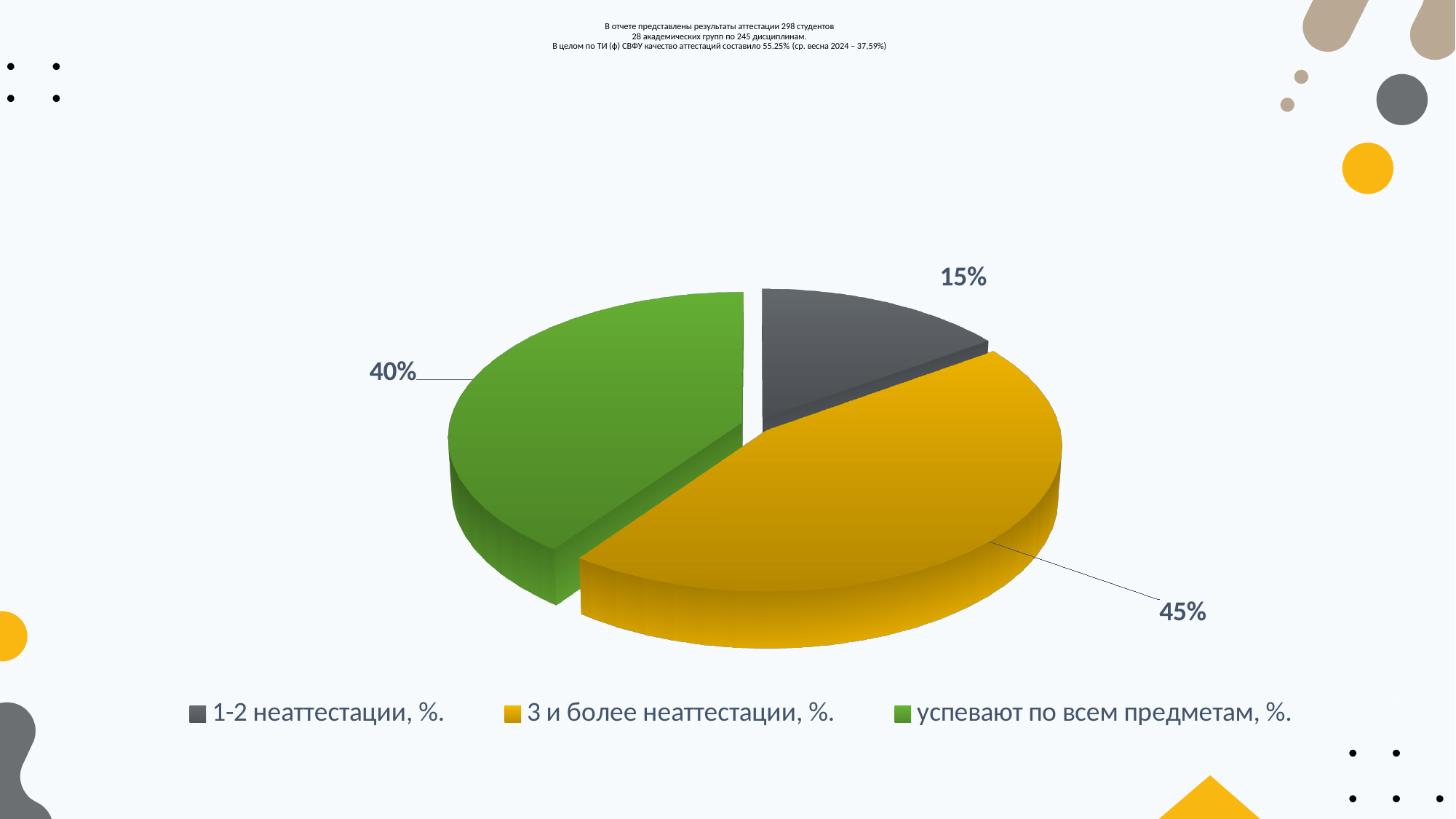
What is the value for "3 и более неаттестации, %."? 45% What kind of chart is shown on the slide? pie chart What is the value for "1-2 неаттестации, %."? 15% What is the value for "успевают по всем предметам, %."? 40% What is the difference between the values for "3 и более неаттестации, %." and "успевают по всем предметам, %."? 5% How many entries does the legend list? 3 What colour is the slice for "успевают по всем предметам, %."? green How many slices does the pie chart have? 3 What is the difference between the values for "успевают по всем предметам, %." and "1-2 неаттестации, %."? 25% Which category has the largest share of the pie? 3 и более неаттестации, %. Which category has the smallest share of the pie? 1-2 неаттестации, %. Which is larger: the value for "1-2 неаттестации, %." or the value for "успевают по всем предметам, %."? успевают по всем предметам, %.